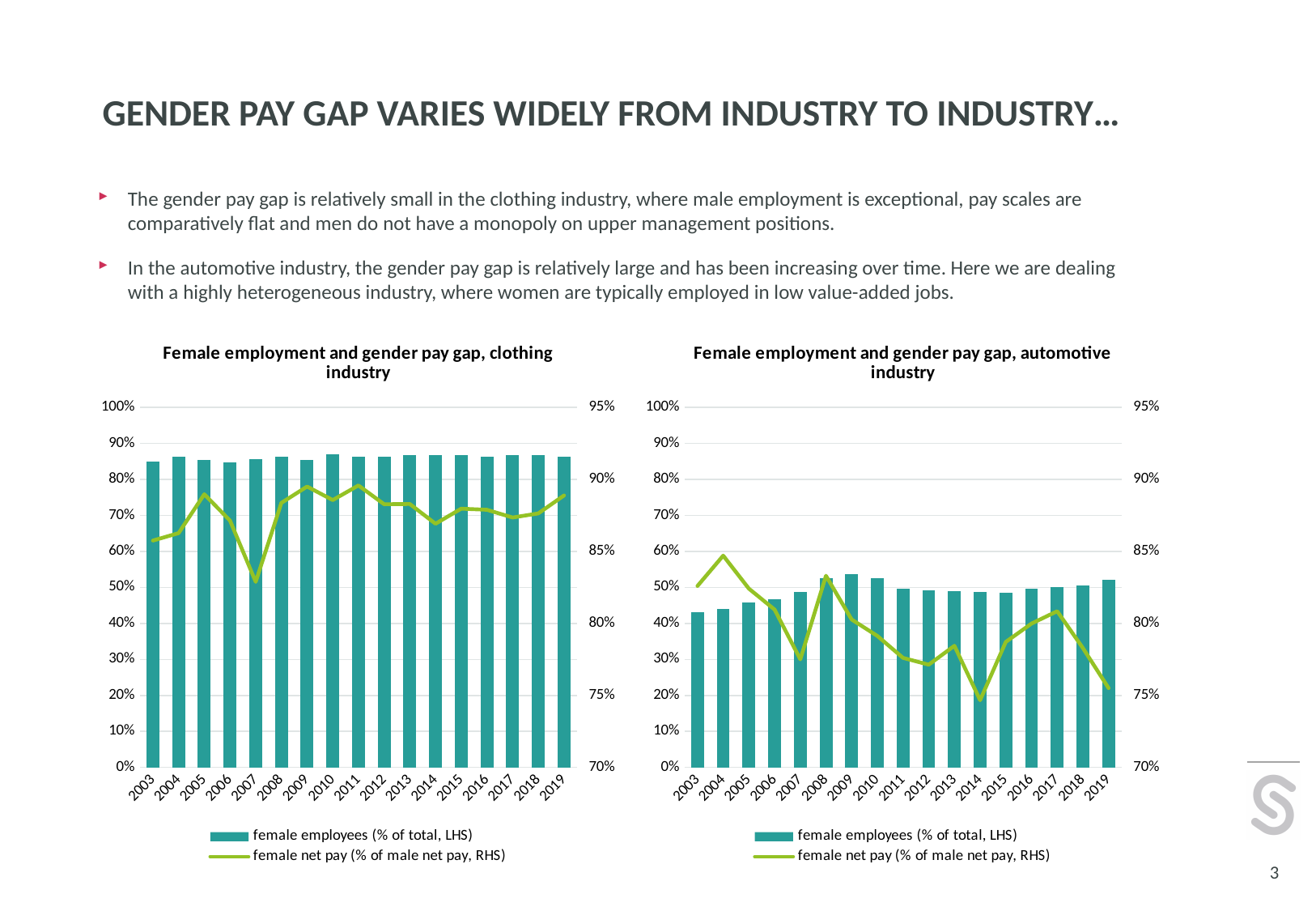
On the automotive industry chart, is the value for female employees in 2003 greater or less than 50%? less On the clothing industry chart, in which year is female net pay (% of male net pay) lowest? 2007 On the clothing industry chart, is the value for female employees in 2003 greater or less than 80%? greater On the automotive industry chart, which is larger: female employees (% of total) in 2003 or in 2019? 2019 On the automotive industry chart, does female net pay (% of male net pay) rise or fall overall from 2003 to 2019? fall On the automotive industry chart, in which year is female net pay (% of male net pay) highest? 2004 On the automotive industry chart, is the value for female employees in 2009 greater or less than 50%? greater How many series does the legend of the automotive industry chart list? 2 On the clothing industry chart, which is larger: female net pay (% of male net pay) in 2007 or in 2009? 2009 How many years are shown on the x axis of the automotive industry chart? 17 On the automotive industry chart, in which year is female net pay (% of male net pay) lowest? 2014